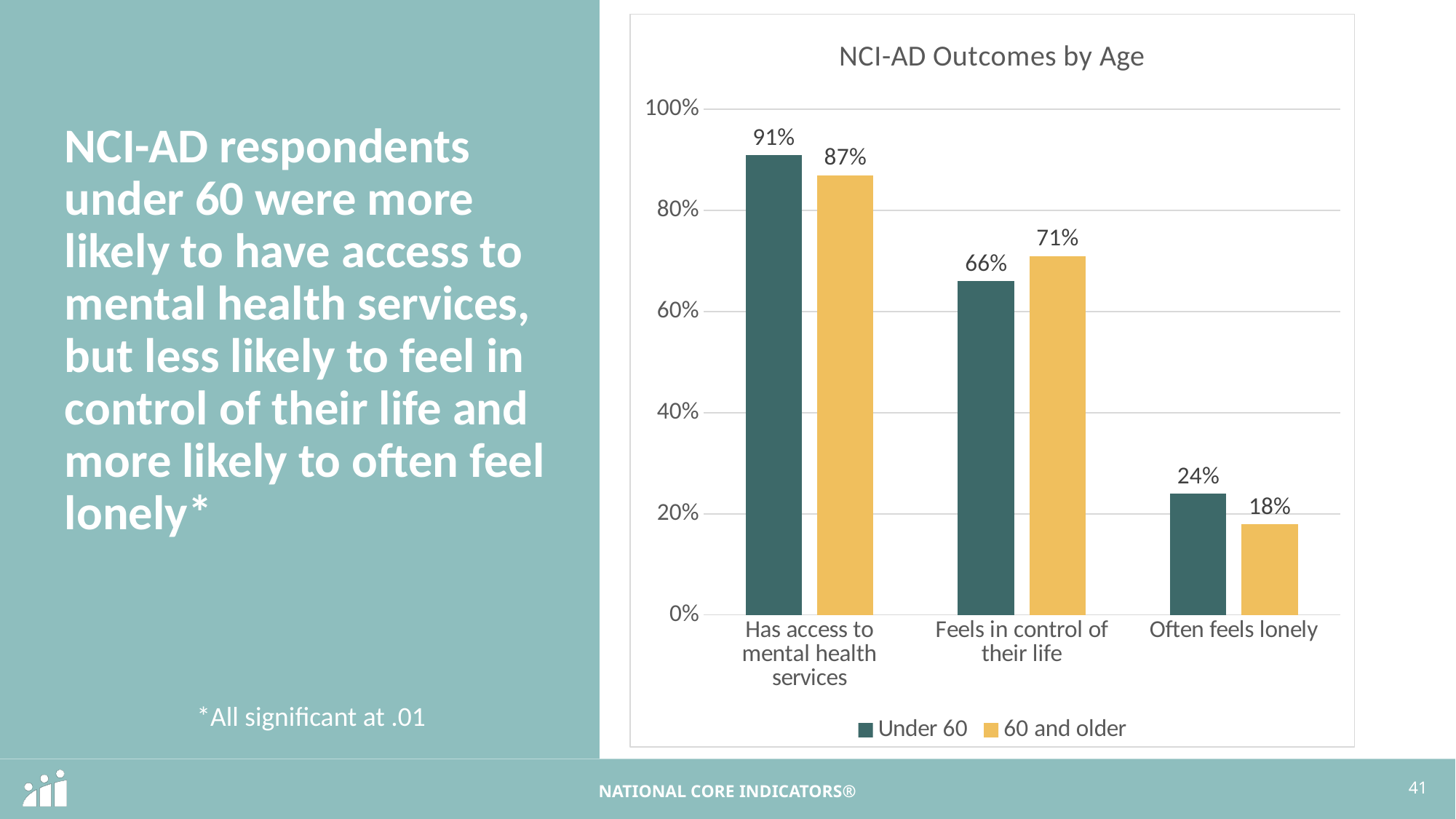
How many series does the legend list? 2 What is the difference between Under 60 and 60 and older in the 'Often feels lonely' category? 6% How many categories are shown on the x axis? 3 What kind of chart is shown on the slide? Bar chart What is the value for 60 and older in the 'Feels in control of their life' category? 71% What is the value for Under 60 in the 'Often feels lonely' category? 24% Which category has the highest value for the 60 and older series? Has access to mental health services Which is larger in the 'Feels in control of their life' category: Under 60 or 60 and older? 60 and older What is the title of the chart? NCI-AD Outcomes by Age What is the value for Under 60 in the 'Has access to mental health services' category? 91% What is the difference between 60 and older and Under 60 in the 'Feels in control of their life' category? 5% Which category has the lowest value for the Under 60 series? Often feels lonely